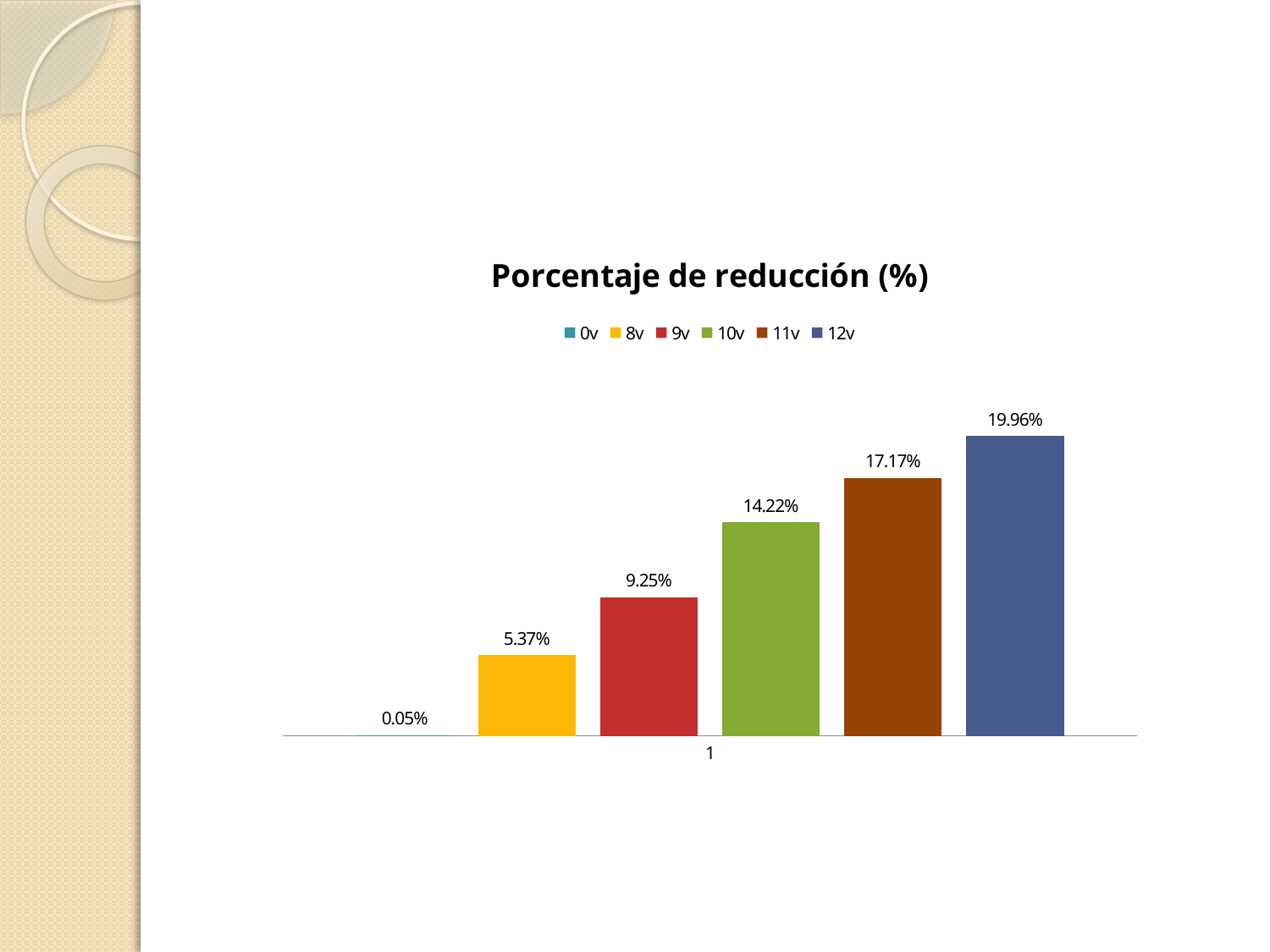
What is the value for the 9v series? 9.25% What is the difference between the values for 10v and 8v? 8.85% What is the value for the 0v series? 0.05% What kind of chart is shown on the slide? bar chart What is the title of the chart? Porcentaje de reducción (%) Which series has the lowest value? 0v Do the values rise or fall from the 0v series to the 12v series? rise What is the value for the 12v series? 19.96% How many series does the legend list? 6 What is the difference between the values for 12v and 11v? 2.79% Which is larger, the value for 10v or the value for 9v? 10v Which series has the highest value? 12v